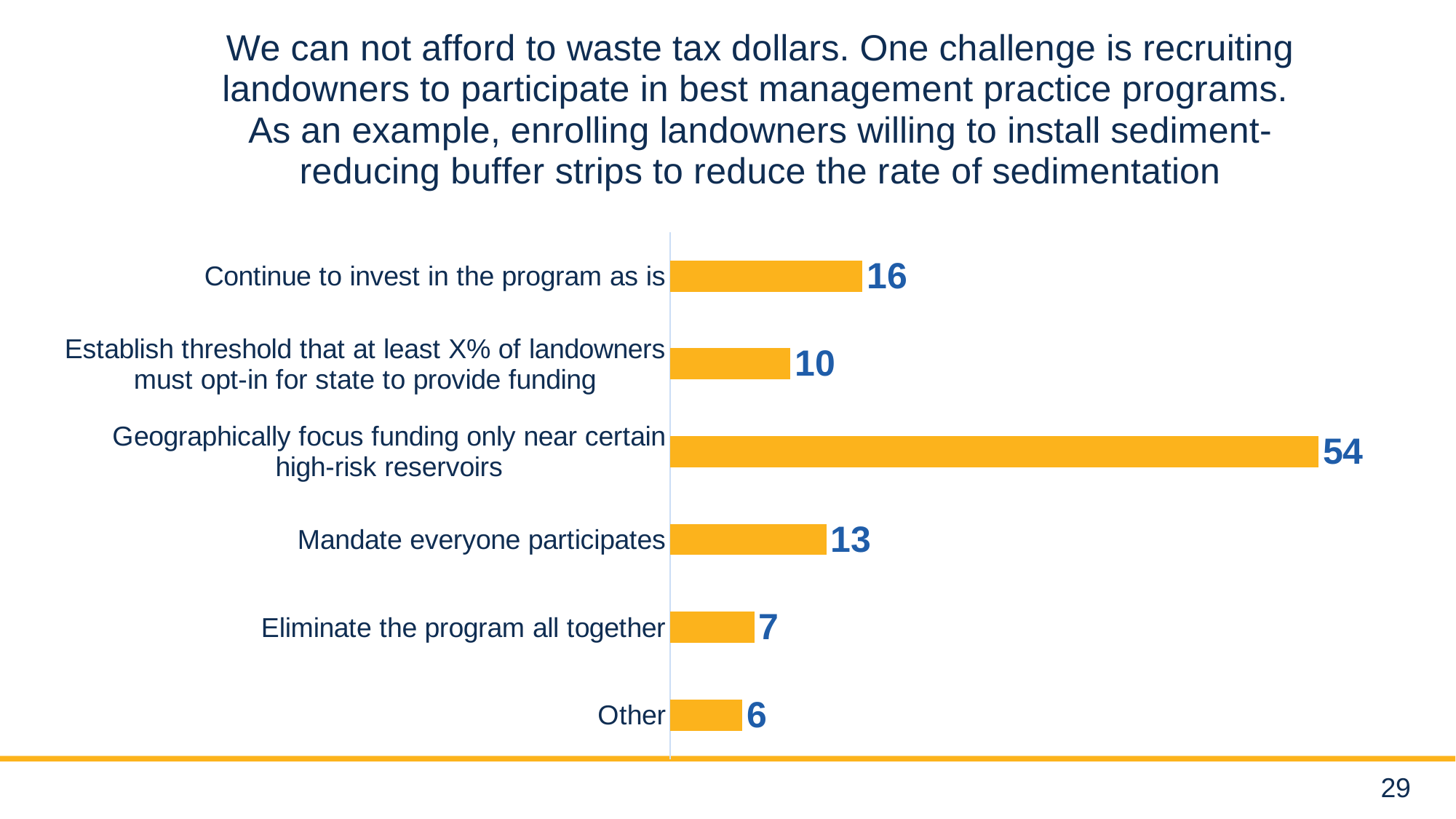
What is the value for "Other"? 6 What is the difference between the values for "Geographically focus funding only near certain high-risk reservoirs" and "Mandate everyone participates"? 41 Which category has the lowest value? Other What is the value for "Geographically focus funding only near certain high-risk reservoirs"? 54 What is the value for "Continue to invest in the program as is"? 16 Which is larger, the value for "Eliminate the program all together" or the value for "Establish threshold that at least X% of landowners must opt-in for state to provide funding"? Establish threshold that at least X% of landowners must opt-in for state to provide funding What colour are the bars in the chart? Orange What is the difference between the values for "Continue to invest in the program as is" and "Establish threshold that at least X% of landowners must opt-in for state to provide funding"? 6 Which category has the highest value? Geographically focus funding only near certain high-risk reservoirs What kind of chart is shown on the slide? Bar chart How many categories are shown in the chart? 6 What is the value for "Mandate everyone participates"? 13